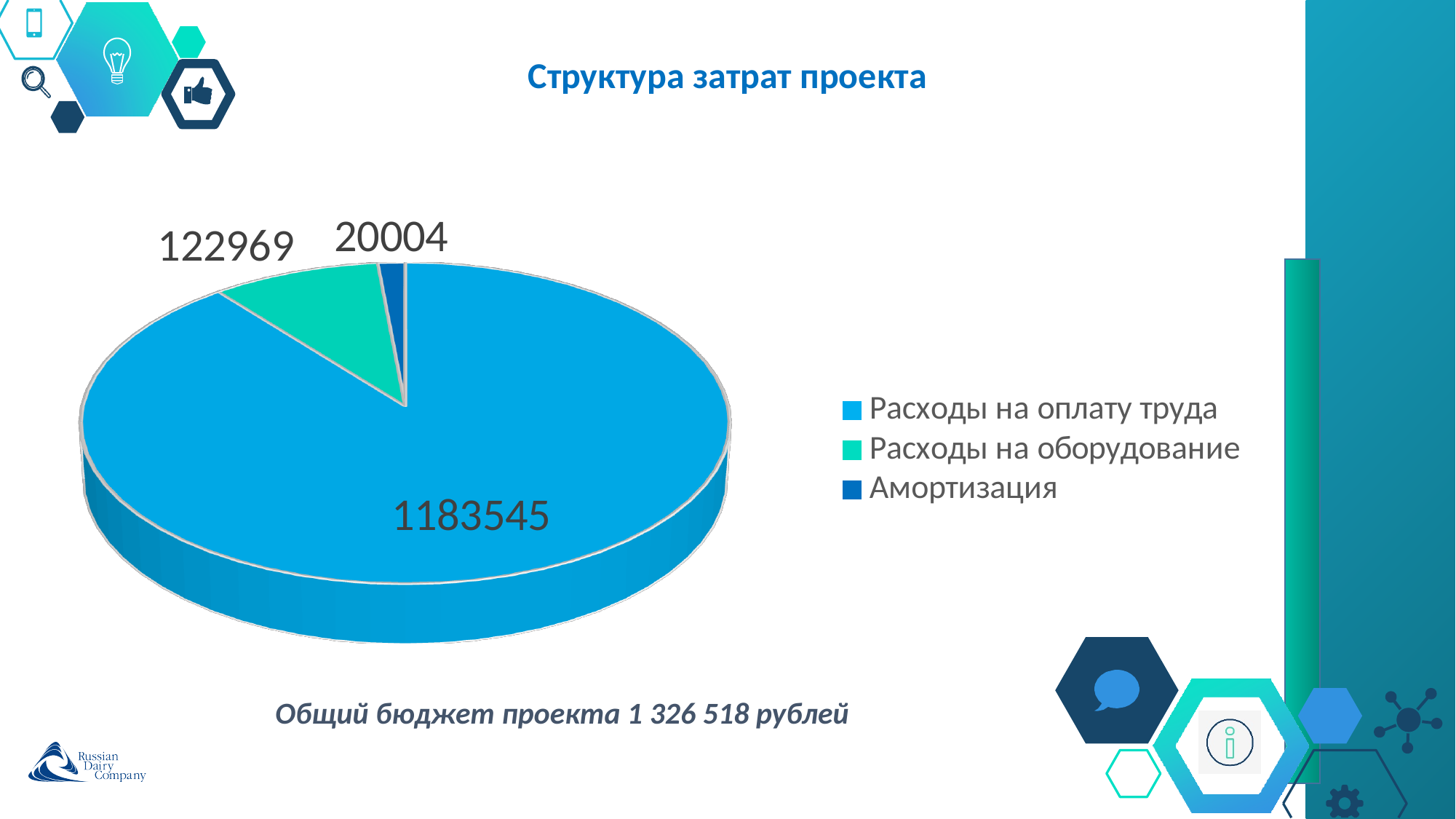
Which category has the smallest slice of the pie? Амортизация What is the difference between Расходы на оплату труда and Расходы на оборудование? 1060576 What is the value for Расходы на оборудование? 122969 What is the value for Амортизация? 20004 What is the value for Расходы на оплату труда? 1183545 What is the difference between Расходы на оборудование and Амортизация? 102965 What type of chart is shown on the slide? Pie chart Which category has the largest slice of the pie? Расходы на оплату труда How many categories does the pie chart show? 3 What is the title of the chart? Структура затрат проекта What is the total of all slices in the pie chart? 1326518 Which is larger, Расходы на оборудование or Амортизация? Расходы на оборудование